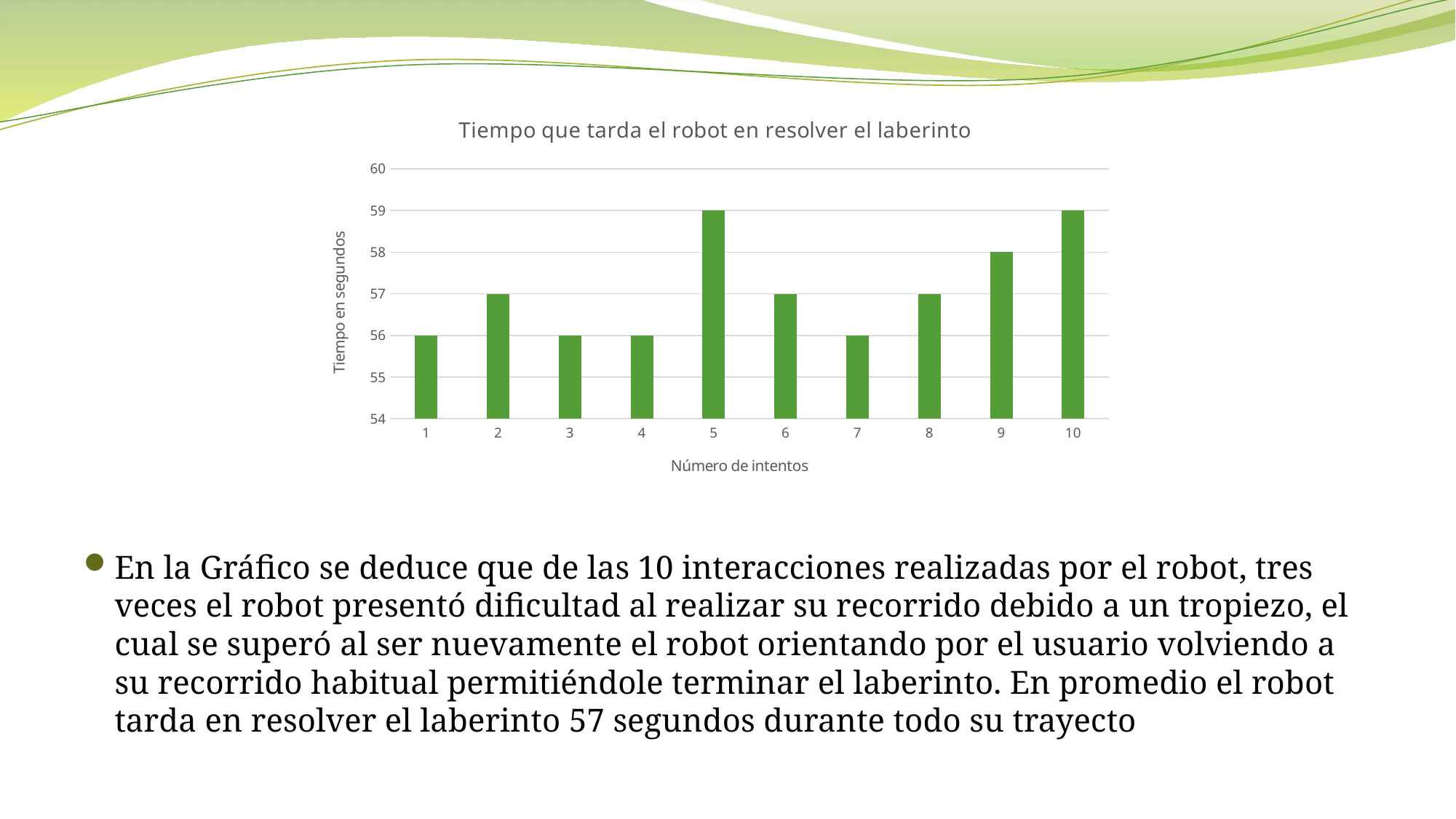
What is the title of the chart? Tiempo que tarda el robot en resolver el laberinto What kind of chart is shown on the slide? bar chart What is the highest time value shown on the chart? 59 What is the label of the y axis? Tiempo en segundos What is the lowest time value shown on the chart? 56 How many attempts (intentos) are plotted on the chart? 10 What is the time in seconds for attempt 9? 58 Which attempt has a higher time, attempt 9 or attempt 2? attempt 9 What is the difference in seconds between attempt 5 and attempt 1? 3 What is the time in seconds for attempt 5? 59 What is the time in seconds for attempt 2? 57 What is the time in seconds for attempt 7? 56